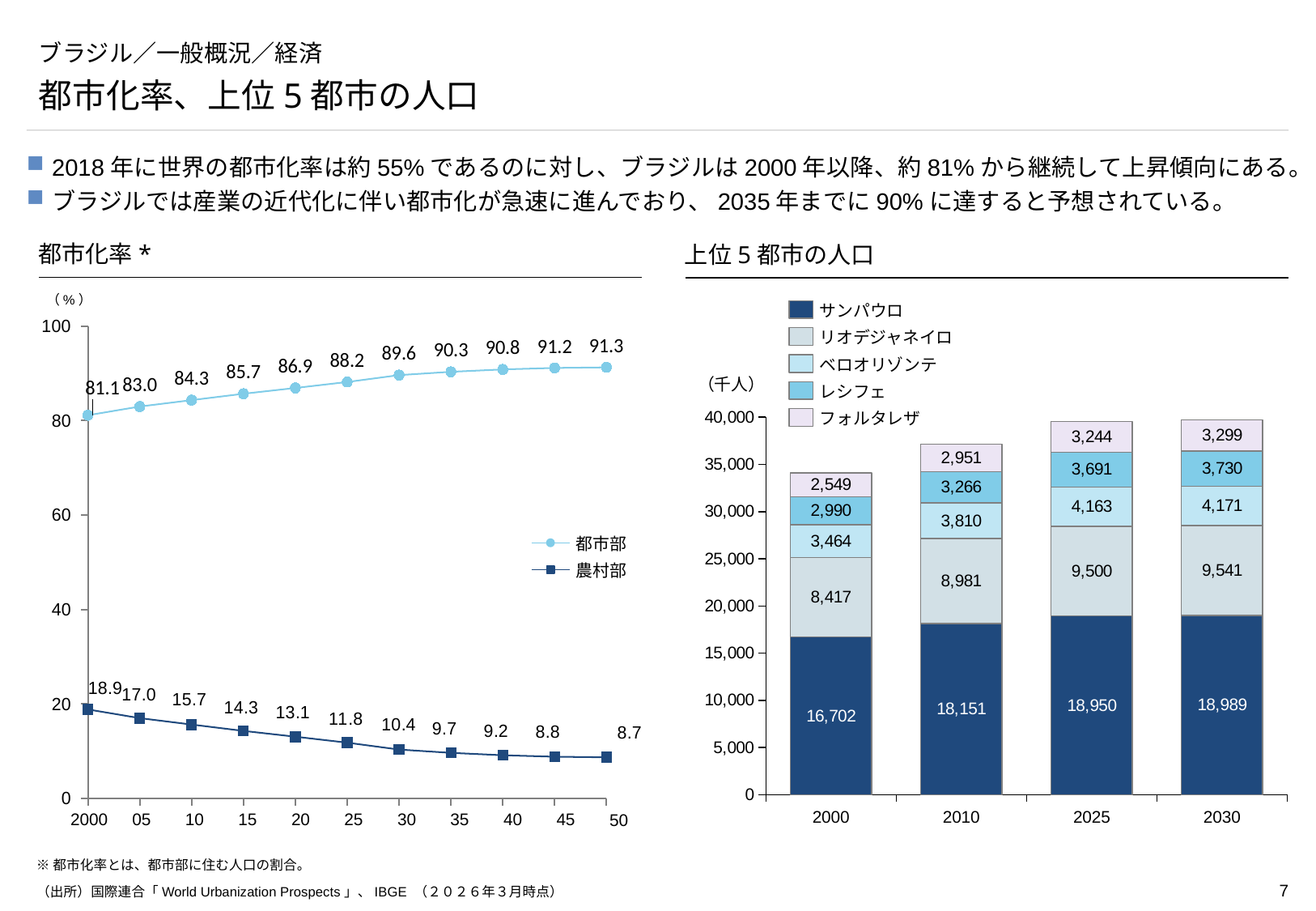
In the 都市化率 chart, in which year is the 農村部 value lowest? 2050 In the 上位5都市の人口 chart, what is the value for サンパウロ in 2010? 18,151 In the 都市化率 chart, what is the difference between the 都市部 and 農村部 values in 2050? 82.6 In the 上位5都市の人口 chart, how many series does the legend list? 5 In the 上位5都市の人口 chart, what is the total of the 2000 bar? 34,122 In the 都市化率 chart, what is the 農村部 value for 2025? 11.8 In the 上位5都市の人口 chart, which is larger: レシフェ in 2025 or ベロオリゾンテ in 2000? レシフェ in 2025 In the 都市化率 chart, does the 都市部 series rise or fall from 2000 to 2050? rise In the 都市化率 chart, what is the 都市部 value for 2000? 81.1 What kind of chart is the 上位5都市の人口 chart? stacked bar chart In the 上位5都市の人口 chart, what is the difference between リオデジャネイロ in 2030 and in 2000? 1,124 In the 都市化率 chart, how many series does the legend list? 2